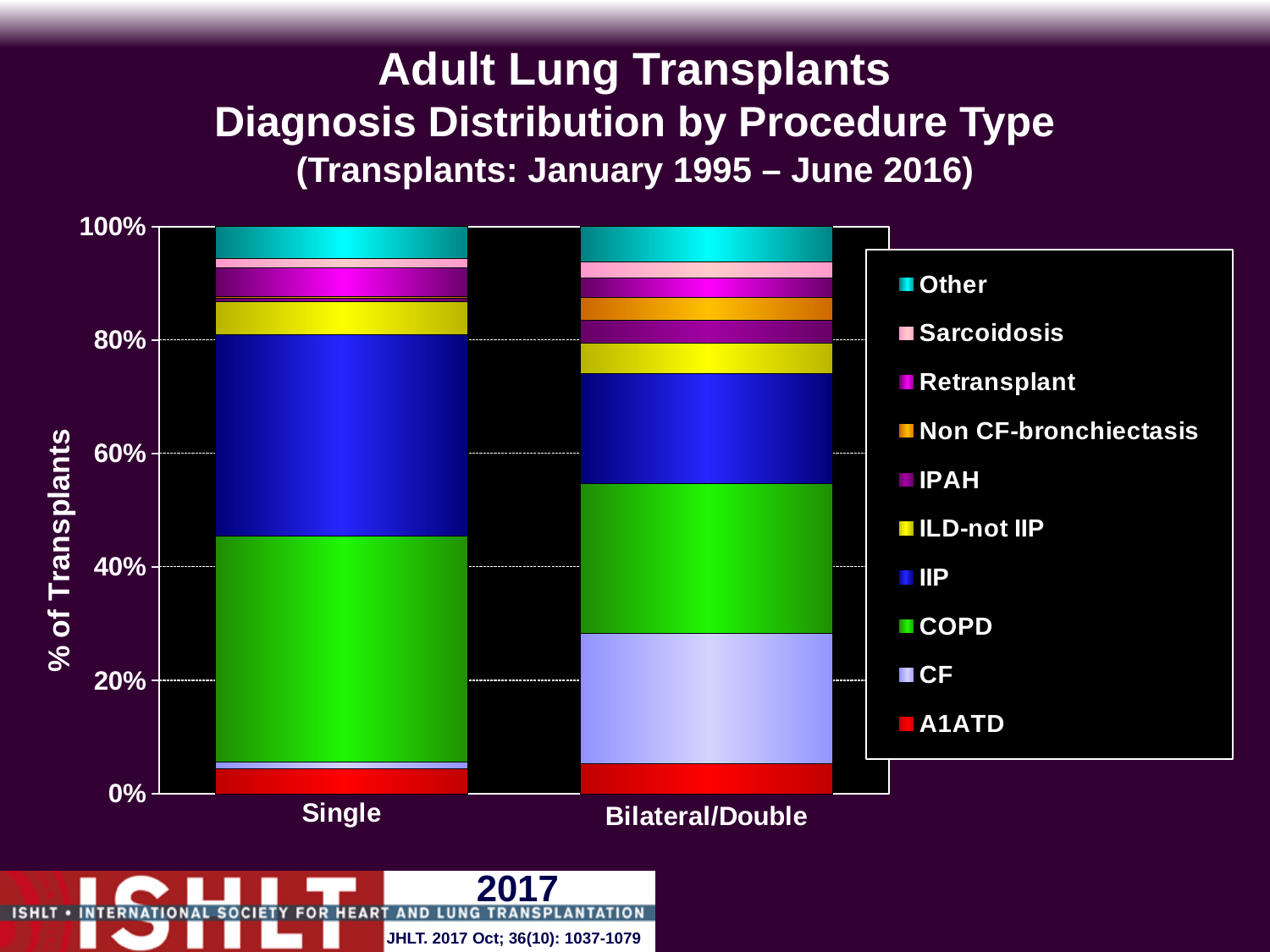
Which diagnosis is the largest segment in the Single bar? COPD How many procedure-type categories are shown on the x axis? 2 What is the label of the y axis? % of Transplants Which procedure type has the larger COPD segment, Single or Bilateral/Double? Single What is the total height of the Single stacked bar? 100% What time period of transplants does the chart title say it covers? January 1995 – June 2016 How many diagnosis series does the legend list? 10 Which procedure type has the larger IIP segment, Single or Bilateral/Double? Single What kind of chart is shown on the slide? Stacked bar chart Which procedure type has the larger CF segment, Single or Bilateral/Double? Bilateral/Double Which diagnosis is the largest segment in the Bilateral/Double bar? COPD Is the CF segment in the Bilateral/Double bar greater or less than 20% of transplants? greater